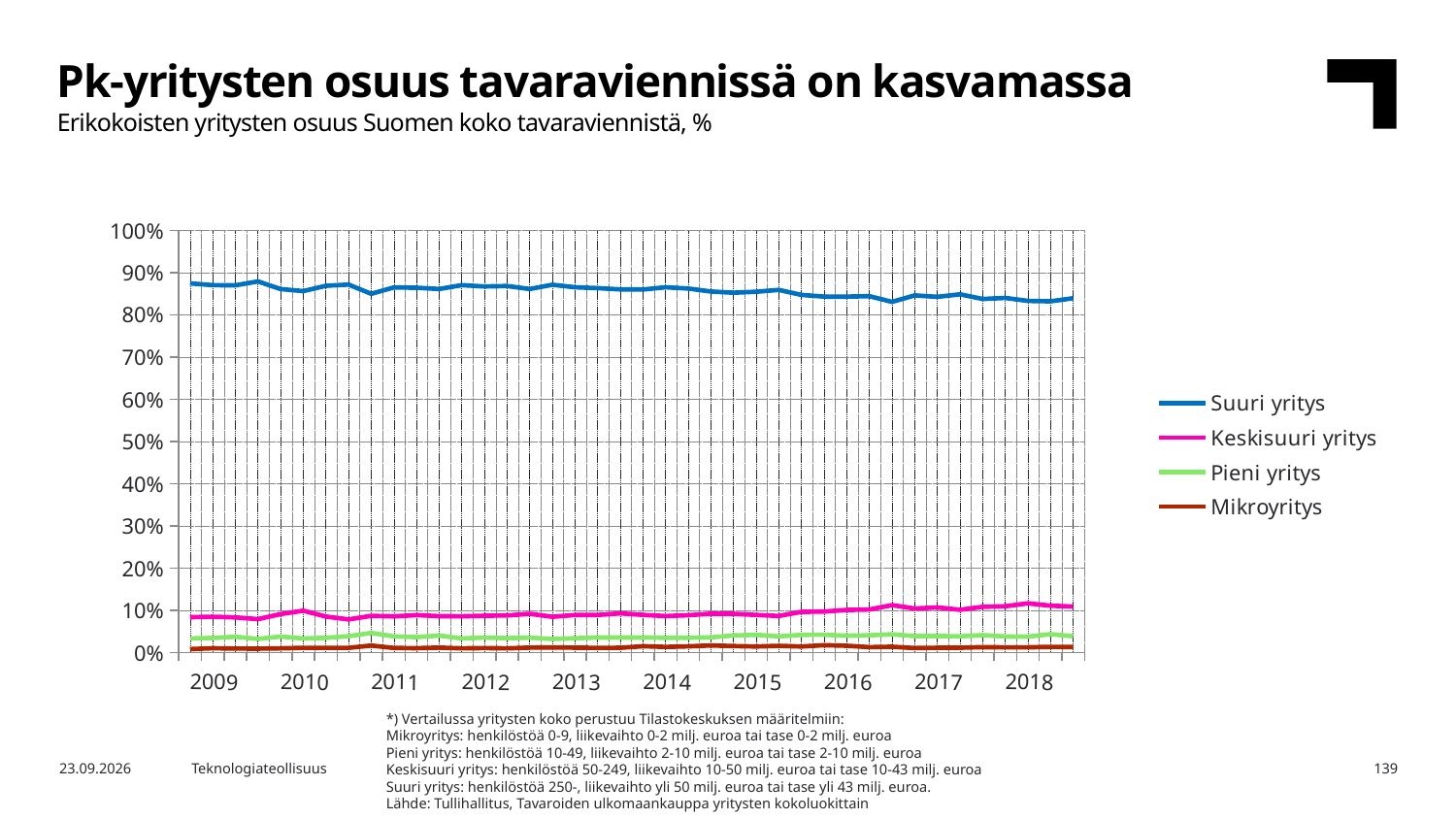
Which series has the highest values throughout the chart? Suuri yritys How many series does the chart legend list? 4 Does the Suuri yritys line rise or fall from 2009 to 2018? Fall Is the value for Keskisuuri yritys in 2018 greater or less than 20%? less What kind of chart is shown on the slide? Line chart Is the value for Suuri yritys in 2009 greater or less than 80%? greater What colour is the line for Keskisuuri yritys? Pink (magenta) Which series has the lowest values throughout the chart? Mikroyritys Which is larger in 2018, the value for Keskisuuri yritys or the value for Pieni yritys? Keskisuuri yritys Is the value for Pieni yritys in 2018 greater or less than 10%? less How many years are labelled on the x axis? 10 Which is larger in 2012, the value for Pieni yritys or the value for Mikroyritys? Pieni yritys